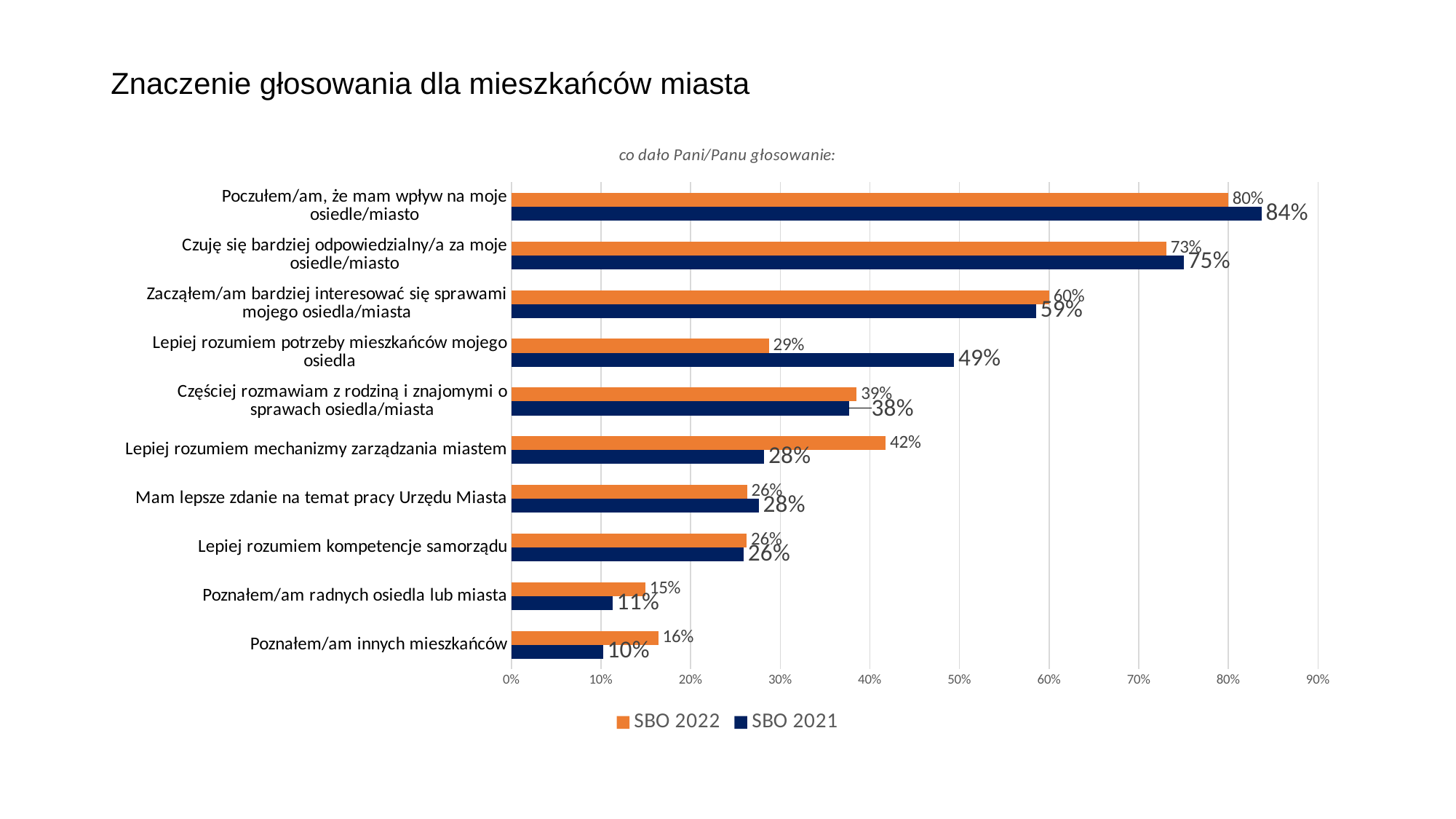
Is the SBO 2022 value for "Zacząłem/am bardziej interesować się sprawami mojego osiedla/miasta" greater or less than 50%? greater What is the SBO 2021 value for "Poczułem/am, że mam wpływ na moje osiedle/miasto"? 84% What is the SBO 2022 value for "Lepiej rozumiem mechanizmy zarządzania miastem"? 42% What is the difference between the SBO 2021 and SBO 2022 values for "Lepiej rozumiem potrzeby mieszkańców mojego osiedla"? 20% What kind of chart is shown on the slide? bar chart Which category has the lowest SBO 2021 value? Poznałem/am innych mieszkańców How many series does the legend list? 2 Which category has the highest SBO 2022 value? Poczułem/am, że mam wpływ na moje osiedle/miasto For "Lepiej rozumiem mechanizmy zarządzania miastem", which series has the larger value, SBO 2022 or SBO 2021? SBO 2022 What is the SBO 2021 value for "Lepiej rozumiem potrzeby mieszkańców mojego osiedla"? 49% Which colour represents SBO 2021 in the chart? navy blue How many categories are shown on the chart? 10